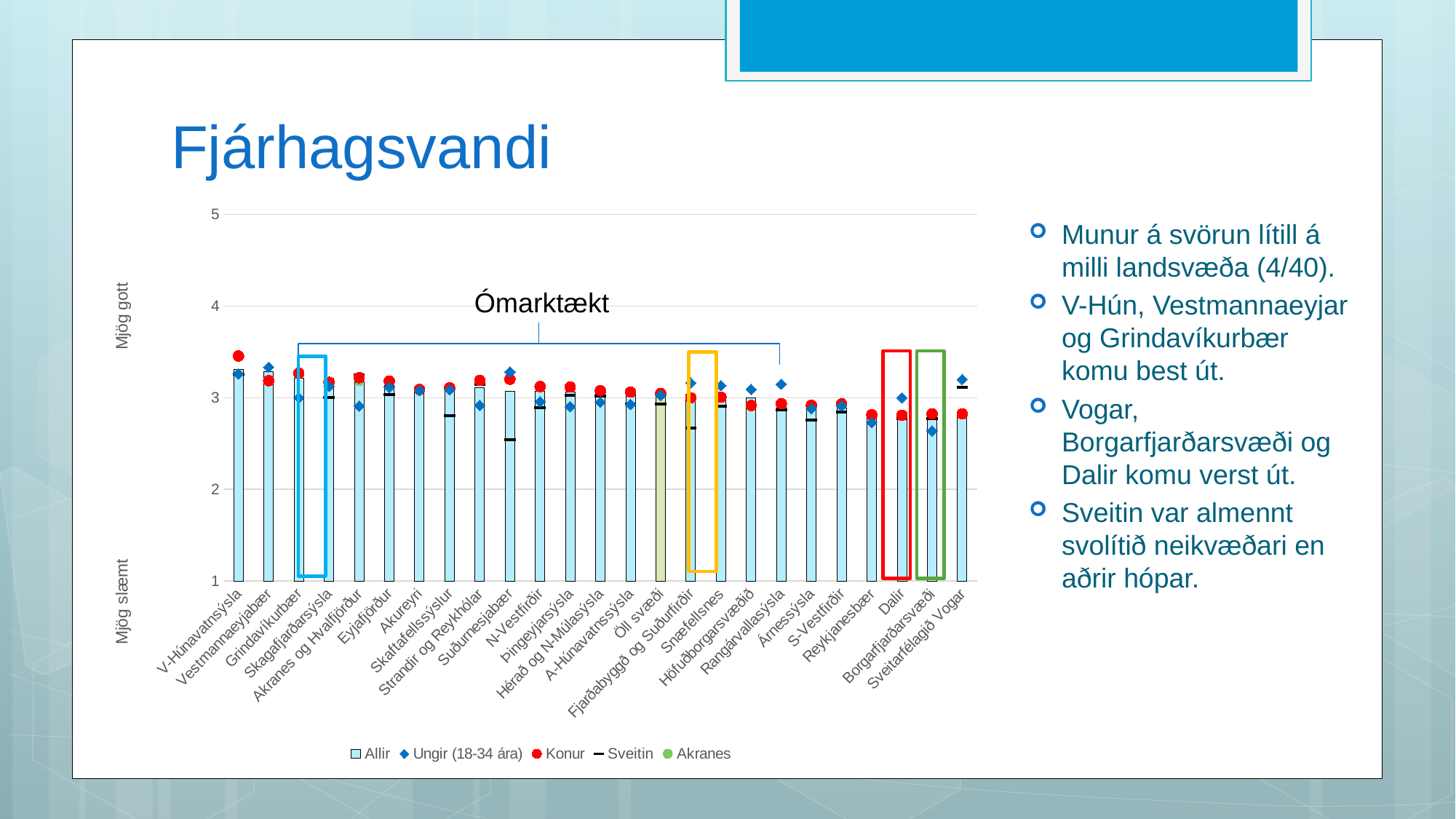
How many categories are shown along the x axis of the chart? 25 Which category has the highest Konur value? V-Húnavatnssýsla Is the Ungir (18-34 ára) value for Fjarðabyggð og Suðurfirðir greater or less than 3? greater How many series does the chart legend list? 5 Is the Allir value for Dalir greater or less than 3? less Is the Allir value for V-Húnavatnssýsla greater or less than 3? greater What kind of chart is shown on the slide? Bar chart with point markers What is the title of the slide containing the chart? Fjárhagsvandi Do the Allir bars generally rise or fall from left to right along the x axis? fall Which is larger, the Allir value for V-Húnavatnssýsla or the Allir value for Dalir? V-Húnavatnssýsla